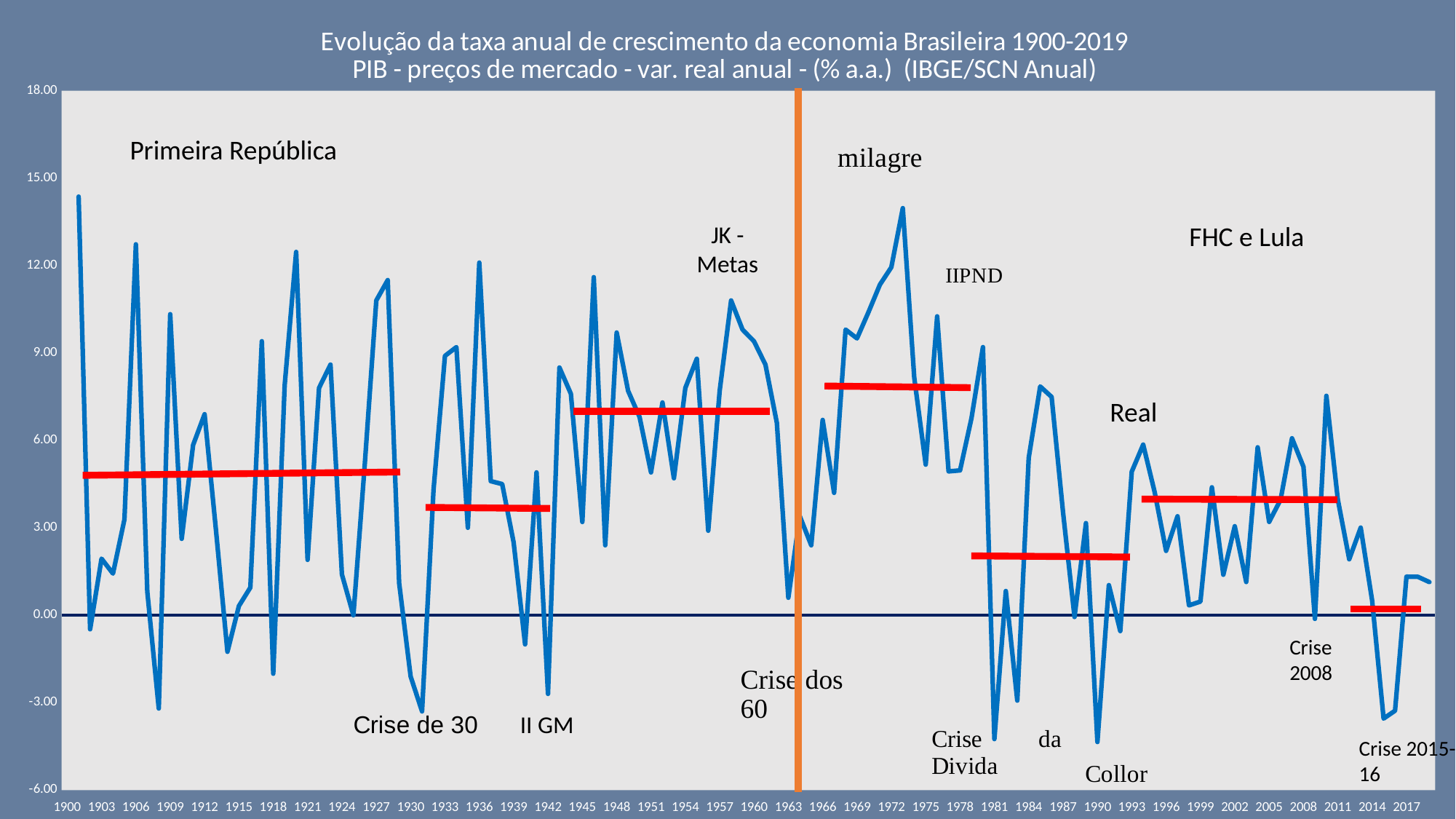
Is the value for 1930 greater or less than 0.00? less What kind of chart is shown on the slide? line chart Is the value for 1942 greater or less than 0.00? less Is the value for 1973 greater or less than 12.00? greater What is the title of the chart? Evolução da taxa anual de crescimento da economia Brasileira 1900-2019 PIB - preços de mercado - var. real anual - (% a.a.) (IBGE/SCN Anual) What is the highest value shown on the y axis? 18.00 Does the line rise or fall between 1900 and 1902? fall Does the line rise or fall between 1967 and 1973? rise How many year labels are shown on the x axis? 40